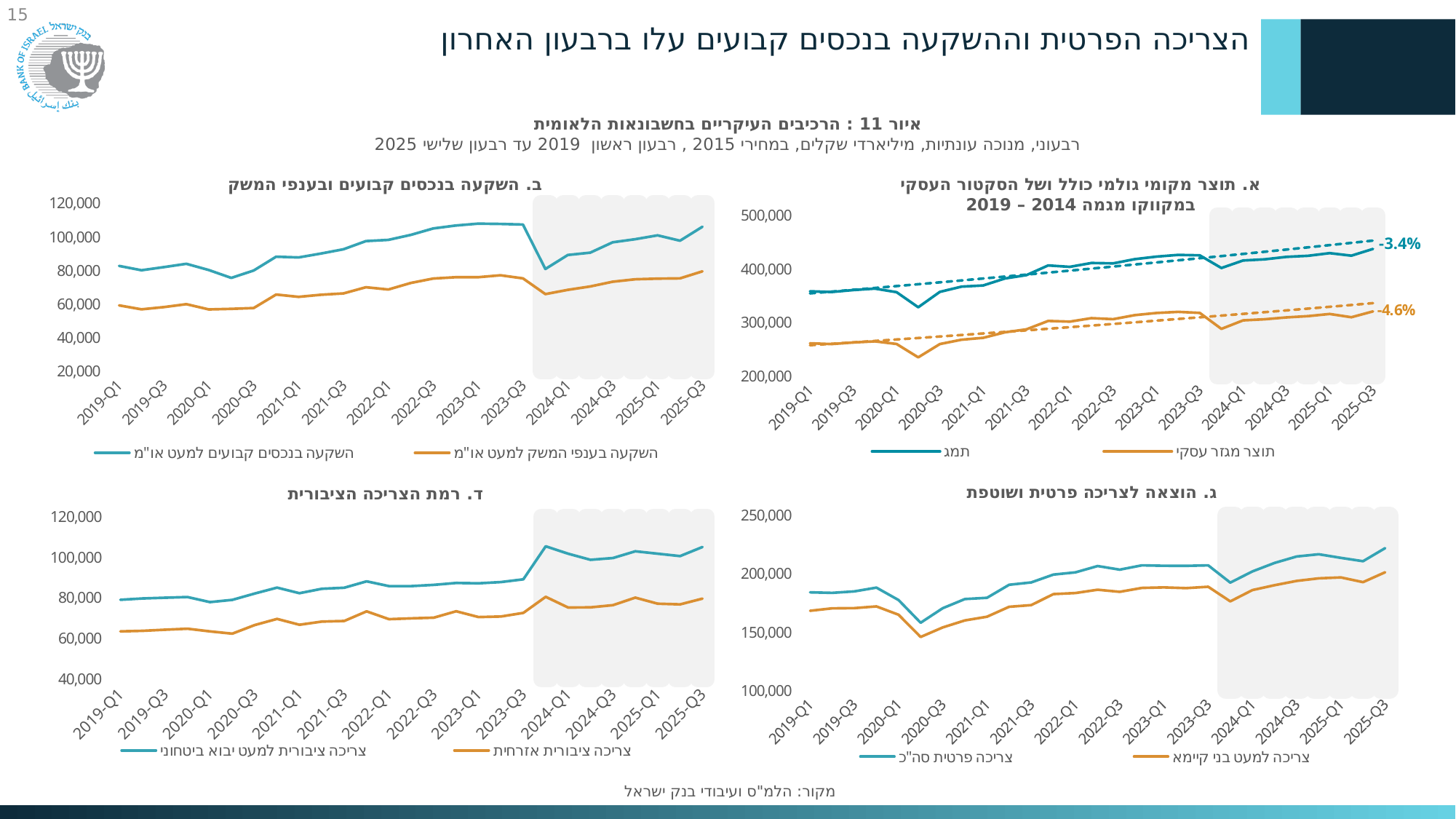
In chart ג (bottom right), is the value of צריכה פרטית סה"כ at 2025-Q3 greater or less than 200,000? greater In chart א (top right), is the value of תמ"ג at 2020-Q3 greater or less than 400,000? less In chart א (top right), what percentage label is shown at the end of the תמ"ג line? -3.4% Which series in chart ג (bottom right) is drawn in orange? צריכה למעט בני קיימא In chart א (top right), what percentage label is shown at the end of the תוצר מגזר עסקי line? -4.6% What is the title of the bottom-left chart? ד. רמת הצריכה הציבורית What kind of chart is chart א (top right, GDP)? line chart In chart ב (top left), which series is higher at 2025-Q3: השקעה בנכסים קבועים למעט או"מ or השקעה בענפי המשק למעט או"מ? השקעה בנכסים קבועים למעט או"מ How many series does the legend of chart ב (top left, investment) list? 2 In chart ג (bottom right), does צריכה פרטית סה"כ overall rise or fall from 2019-Q1 to 2025-Q3? rise In chart ב (top left), is the value of השקעה בנכסים קבועים למעט או"מ at 2025-Q3 greater or less than 100,000? greater